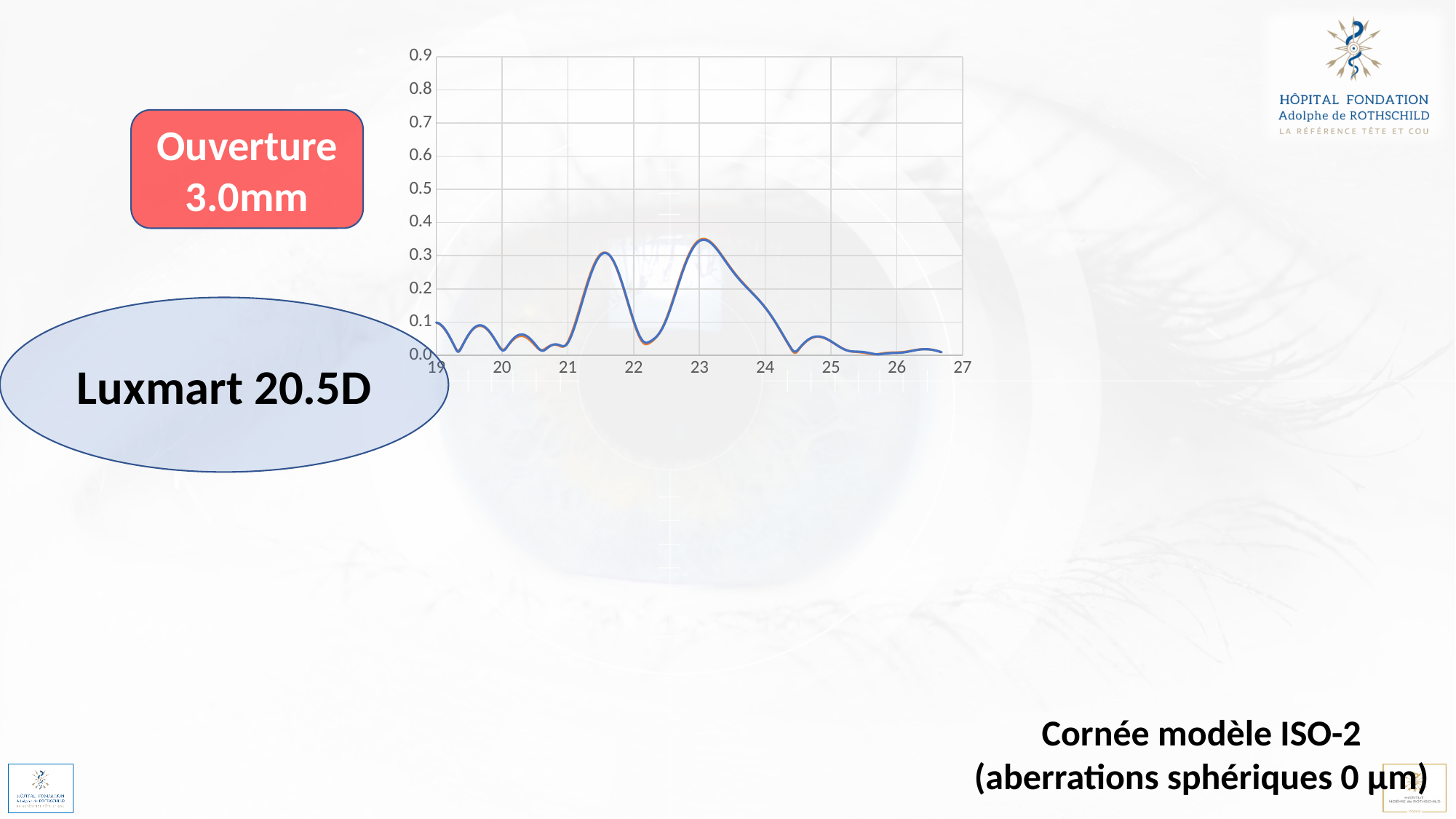
Is the value of the curve at x = 26 greater or less than 0.1? less Which peak is higher: the one near x = 21.5 or the one near x = 23? the one near x = 23 Is the value of the curve at x = 25 greater or less than 0.1? less Is the value of the curve at x = 21.5 greater or less than 0.2? greater Near which x-axis value does the curve reach its highest peak? 23 What is the highest value labelled on the y axis? 0.9 Does the curve rise or fall between x = 22 and x = 23? rise Does the curve rise or fall between x = 23 and x = 24.5? fall What range does the x axis cover? 19 to 27 What kind of chart is shown on the slide? line chart